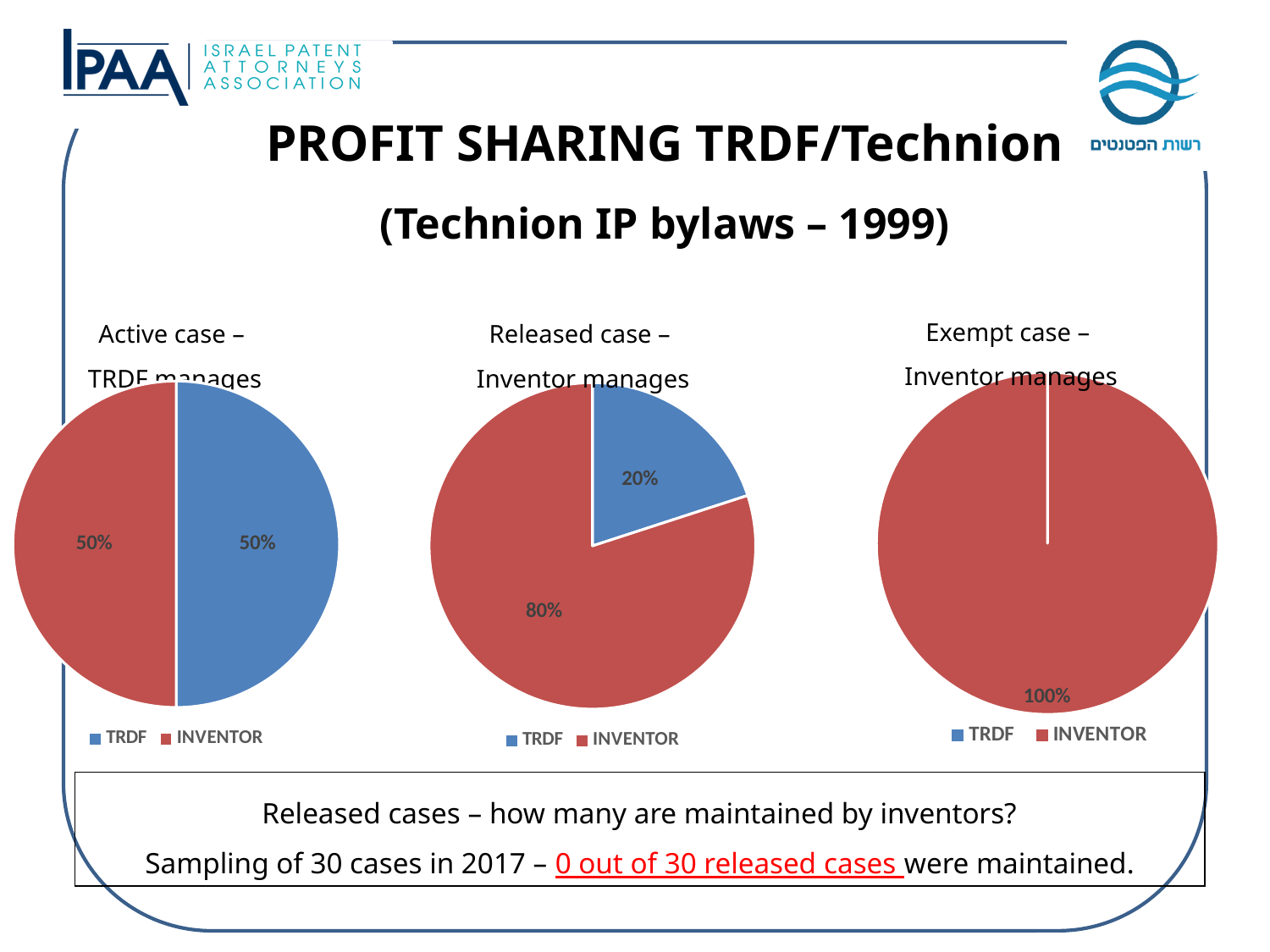
What type of chart is used for the 'Active case – TRDF manages' chart? pie chart In the 'Active case – TRDF manages' pie chart, what share goes to TRDF? 50% In the 'Released case – Inventor manages' pie chart, which party receives the larger share? INVENTOR In the 'Released case – Inventor manages' pie chart, which party receives the smaller share? TRDF In the 'Exempt case – Inventor manages' pie chart, what share goes to INVENTOR? 100% In the 'Released case – Inventor manages' pie chart, what share goes to TRDF? 20% How many pie charts are shown on the slide? 3 In the 'Released case – Inventor manages' pie chart, what is the difference between the INVENTOR share and the TRDF share? 60% In the 'Released case – Inventor manages' pie chart, what share goes to INVENTOR? 80% In the 'Active case – TRDF manages' pie chart, which colour represents INVENTOR? red In the 'Released case – Inventor manages' pie chart, is the TRDF share larger or smaller than the INVENTOR share? smaller How many entries does the legend of the 'Exempt case – Inventor manages' chart list? 2